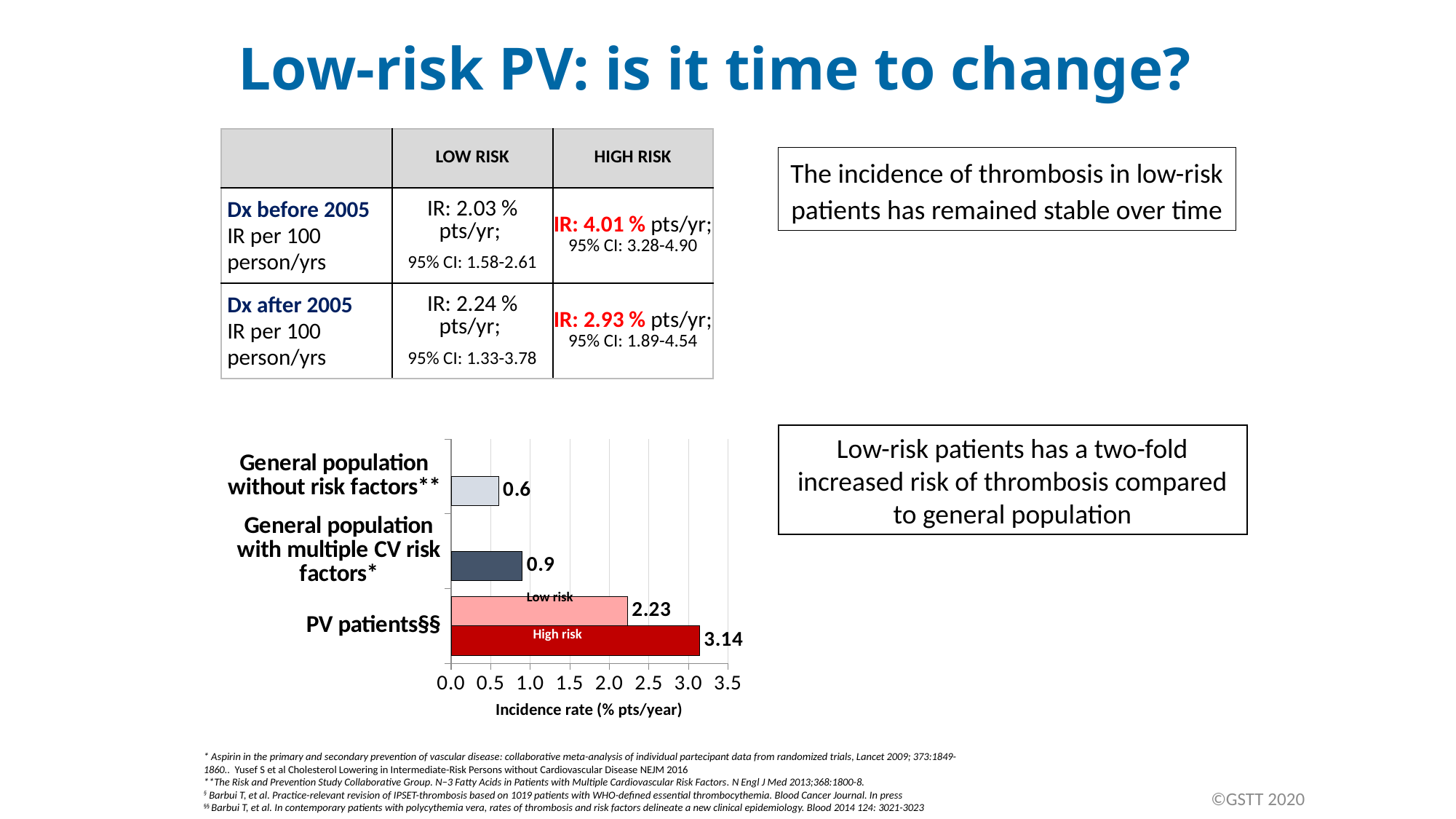
What is the incidence rate for the general population without risk factors? 0.6 What is the difference in incidence rate between the general population with multiple CV risk factors and the general population without risk factors? 0.3 What is the label of the x axis of the chart? Incidence rate (% pts/year) What is the incidence rate for low-risk PV patients? 2.23 How many bars are plotted in the chart? 4 What kind of chart is shown on the slide? bar chart Which bar has the highest incidence rate? High risk PV patients Which is larger: the incidence rate for low-risk PV patients or for the general population with multiple CV risk factors? Low-risk PV patients Which bar has the lowest incidence rate? General population without risk factors What is the difference in incidence rate between high-risk and low-risk PV patients? 0.91 What is the incidence rate for high-risk PV patients? 3.14 What is the incidence rate for the general population with multiple CV risk factors? 0.9